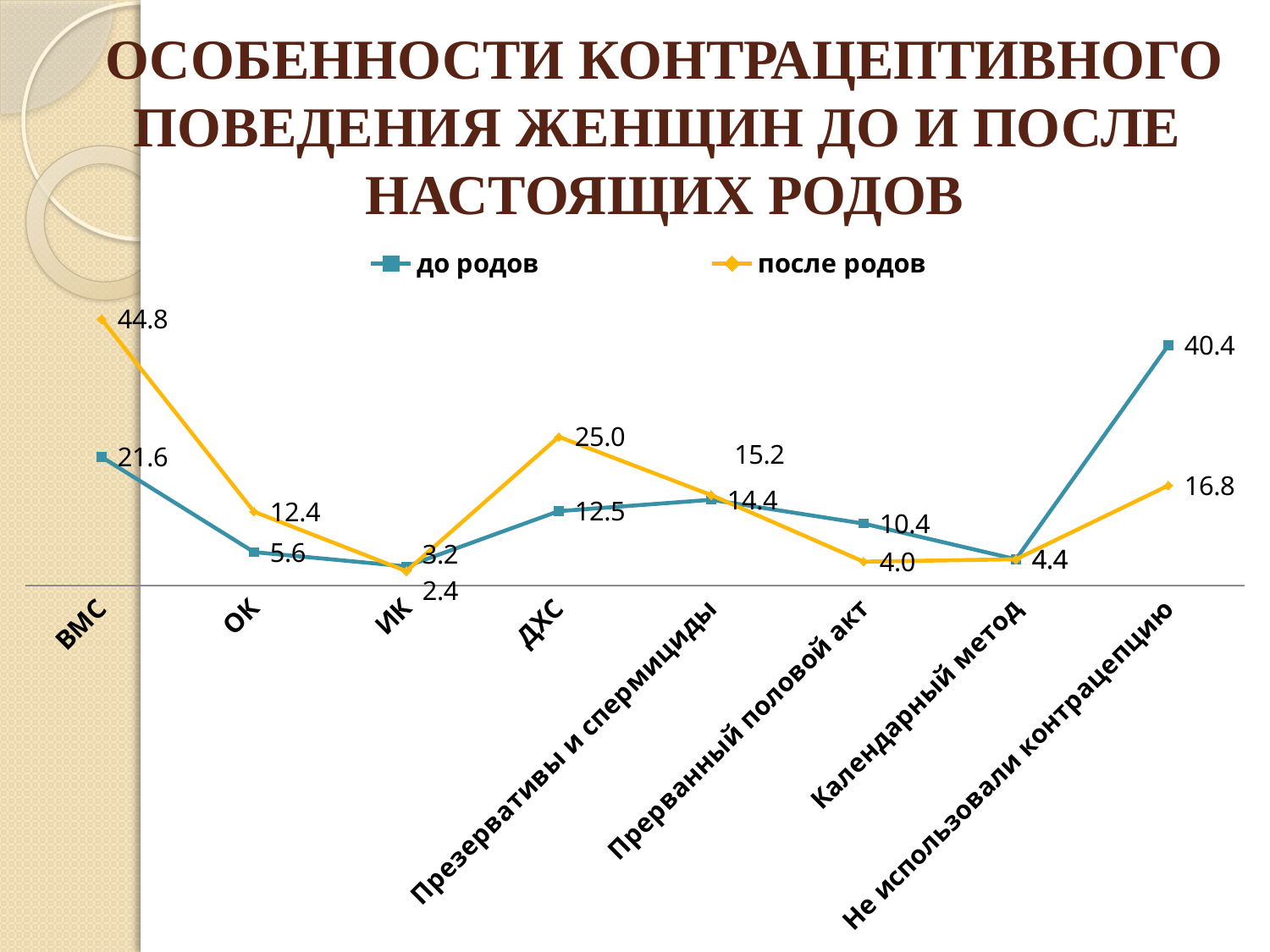
How many categories are shown on the x axis? 8 What is the value for 'Не использовали контрацепцию' in the 'до родов' series? 40.4 What is the value for ВМС in the 'после родов' series? 44.8 What is the value for ДХС in the 'после родов' series? 25.0 What kind of chart is shown on the slide? line chart Which category has the highest value in the 'после родов' series? ВМС What is the difference between the 'после родов' and 'до родов' values for ВМС? 23.2 Which category has the lowest value in the 'после родов' series? ИК How many series does the legend list? 2 What is the value for ВМС in the 'до родов' series? 21.6 Which category has the highest value in the 'до родов' series? Не использовали контрацепцию For 'Прерванный половой акт', which series has the larger value, 'до родов' or 'после родов'? до родов